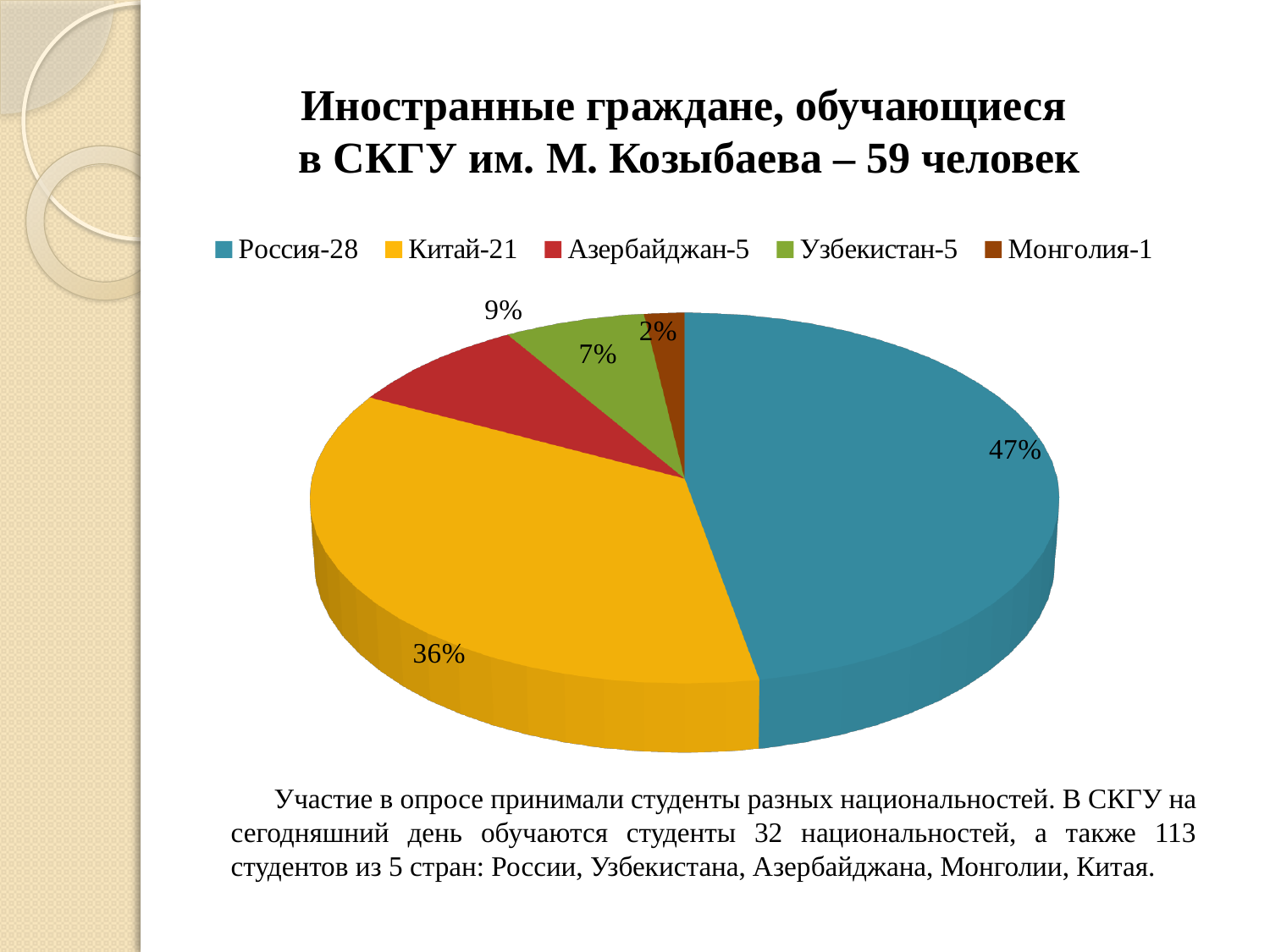
Which slice is larger, Россия or Китай? Россия What kind of chart is shown on the slide? pie chart How many students from Китай (China) are listed in the legend? 21 What percentage of the pie does Китай (China) account for? 36% What percentage label is shown on the Монголия (Mongolia) slice? 2% How many categories (countries) does the pie chart show? 5 What percentage of the pie does Россия (Russia) account for? 47% Which country has the largest slice of the pie? Россия How many students from Азербайджан (Azerbaijan) are listed in the legend? 5 What colour is the slice for Китай (China)? yellow By how many percentage points does the Россия slice exceed the Китай slice? 11 Which country has the smallest slice of the pie? Монголия